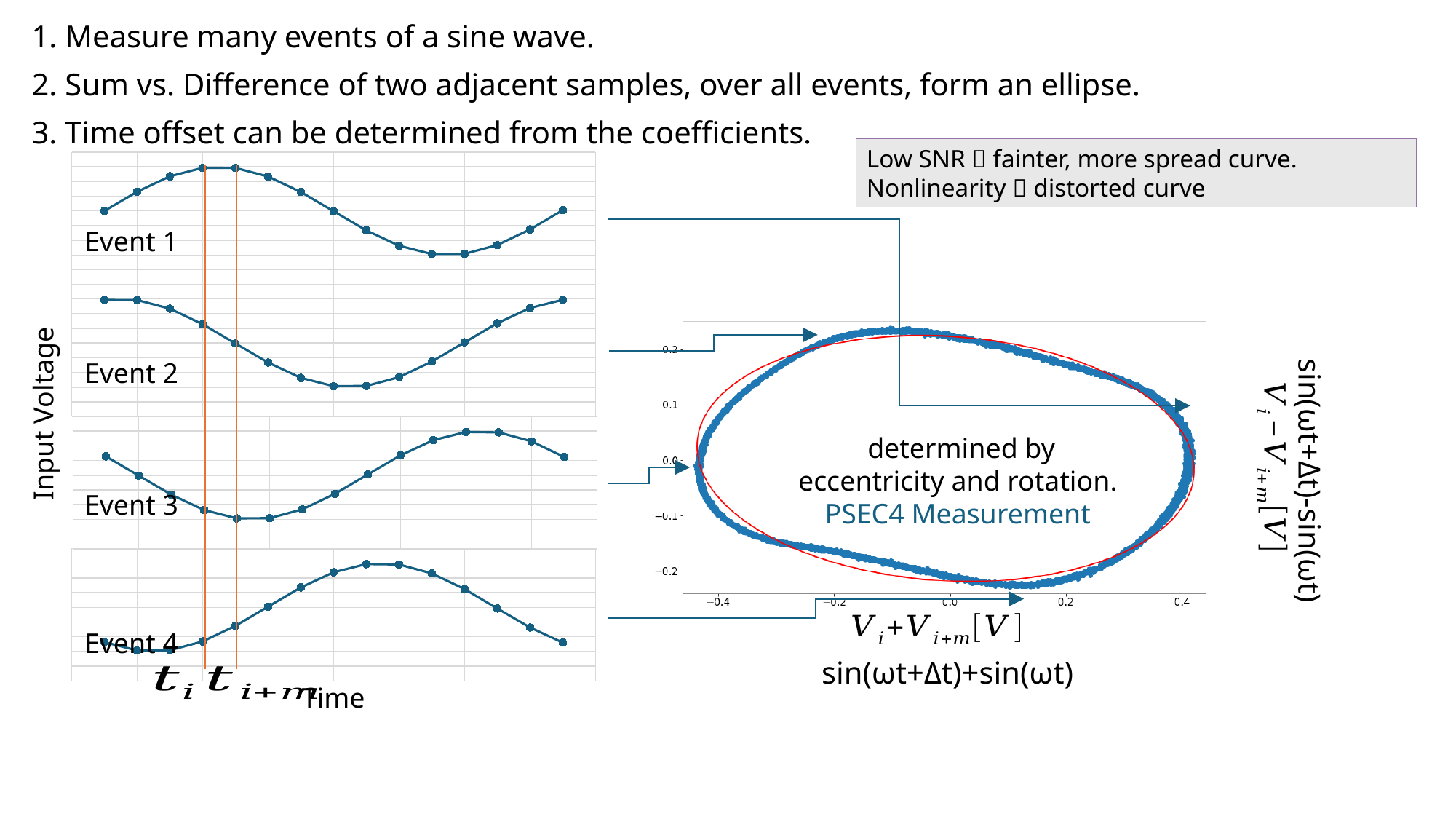
On the right chart, what measurement label is written inside the ellipse? PSEC4 Measurement What kind of chart is the left chart (Input Voltage vs Time)? line chart How many events are plotted on the left chart? 4 On the left chart, which event reaches its peak near the orange line marked t_i? Event 1 What is the y-axis label of the left chart? Input Voltage On the right chart, is the maximum y value of the measured curve greater or less than 0.2? greater On the left chart, do the values of Event 4 rise or fall between t_i and the middle of the time axis? rise On the left chart, do the values of Event 2 rise or fall over the first half of the time axis? fall On the right chart, is the maximum x value of the measured curve greater or less than 0.2? greater On the right chart, is the minimum y value of the measured curve greater or less than -0.2? less